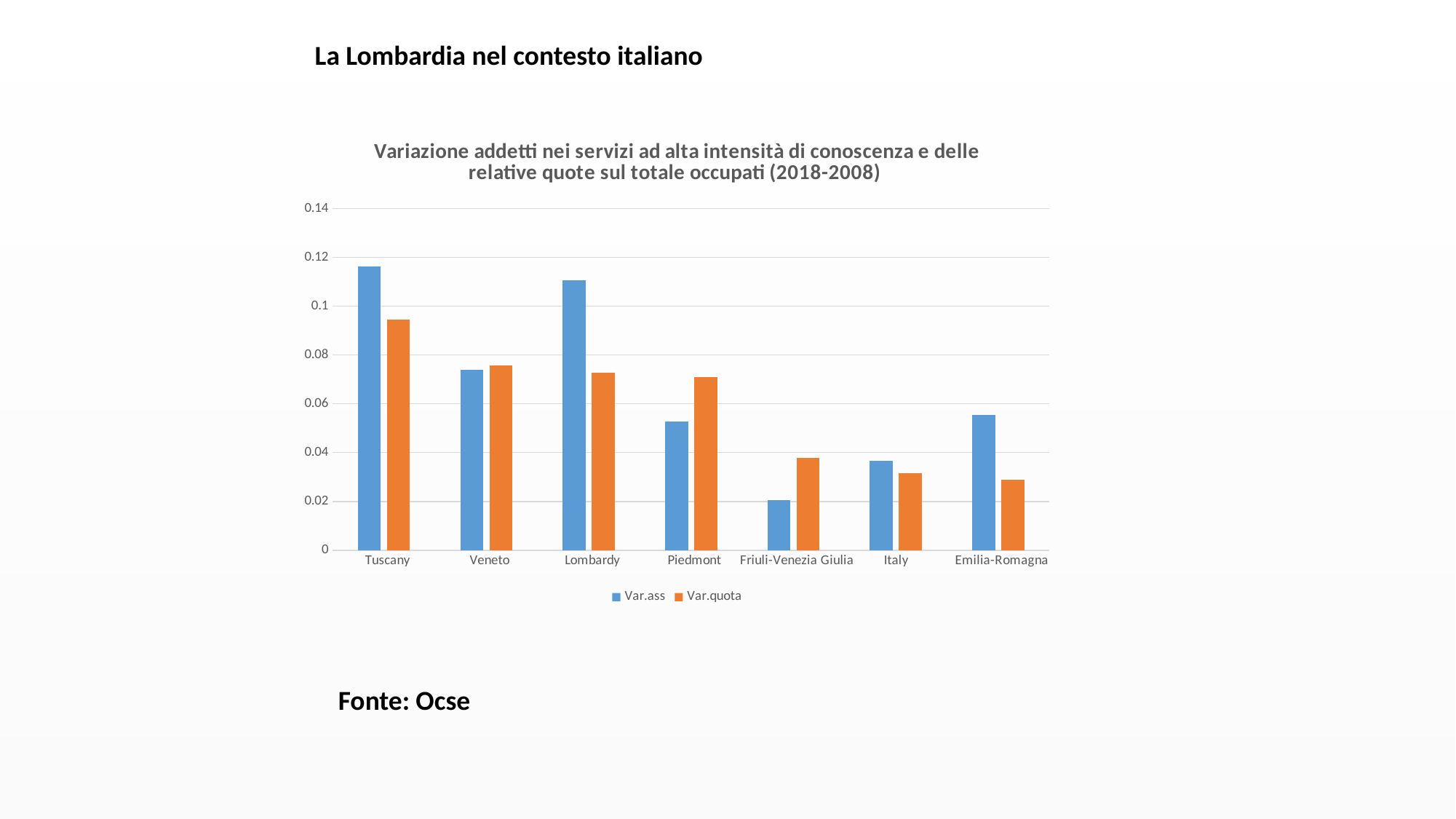
Which category has the highest Var.quota value? Tuscany Is the Var.ass value for Friuli-Venezia Giulia greater or less than 0.04? less Which category has the highest Var.ass value? Tuscany Is the Var.ass value for Lombardy greater or less than 0.1? greater For Piedmont, which is larger: Var.ass or Var.quota? Var.quota What are the two series named in the chart's legend? Var.ass and Var.quota What kind of chart is shown on the slide? Bar chart Which category has the lowest Var.ass value? Friuli-Venezia Giulia How many series does the chart's legend list? 2 Is the Var.quota value for Piedmont greater or less than 0.06? greater For Lombardy, which is larger: Var.ass or Var.quota? Var.ass How many categories are shown on the x axis of the chart? 7